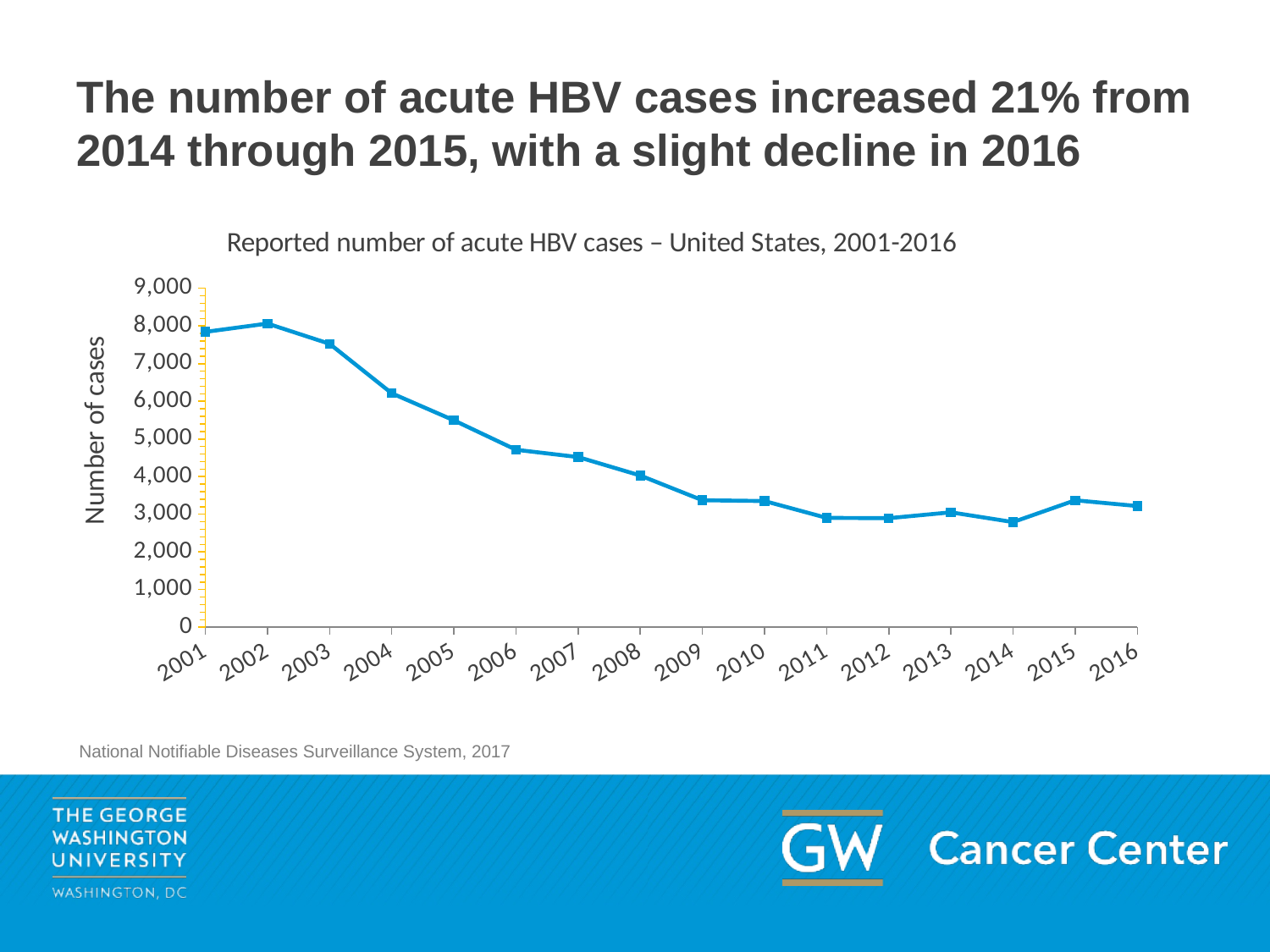
Is the value for 2009 greater or less than 3,000? greater Which year has more reported acute HBV cases, 2014 or 2015? 2015 Is the value for 2006 greater or less than 5,000? less In which year was the reported number of acute HBV cases highest? 2002 Overall, do the reported acute HBV cases rise or fall from 2001 to 2016? Fall What kind of chart is shown on the slide? Line chart Is the value for 2003 greater or less than 7,000? greater Which year has more reported acute HBV cases, 2004 or 2008? 2004 What is the label on the y axis of the chart? Number of cases How many years are plotted on the x axis of the chart? 16 What is the title of the chart? Reported number of acute HBV cases – United States, 2001-2016